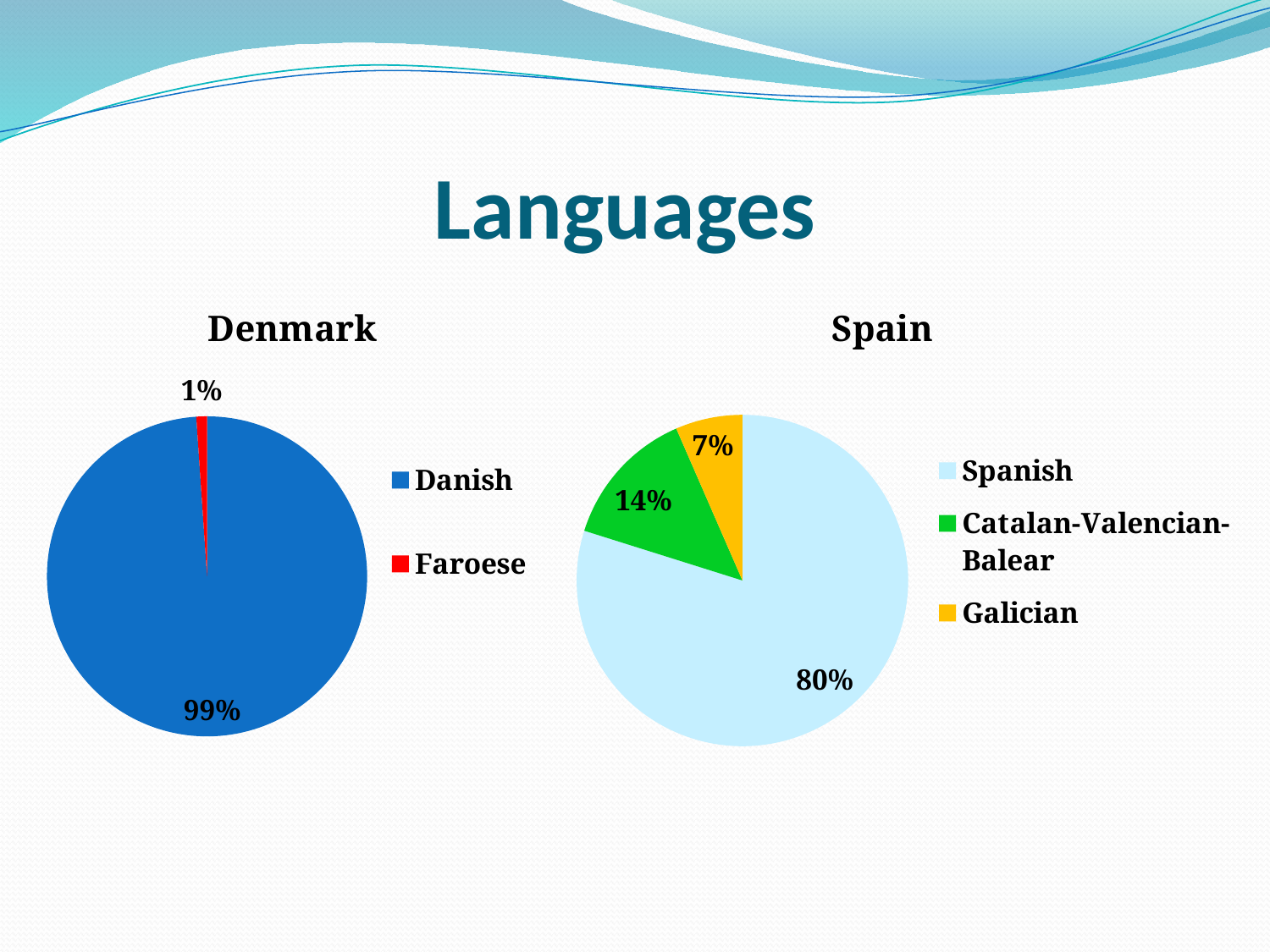
In the Denmark chart, what colour is the Faroese slice? Red In the Spain chart, what is the difference between the Spanish and Catalan-Valencian-Balear shares? 66% In the Spain chart, what share of the pie is Galician? 7% In the Spain chart, which language has the largest slice? Spanish What kind of chart is the Denmark chart? Pie chart In the Spain chart, what share of the pie is Spanish? 80% In the Denmark chart, what share of the pie is Faroese? 1% In the Spain chart, which is larger, Catalan-Valencian-Balear or Galician? Catalan-Valencian-Balear How many slices does the Spain chart have? 3 In the Spain chart, which language has the smallest slice? Galician